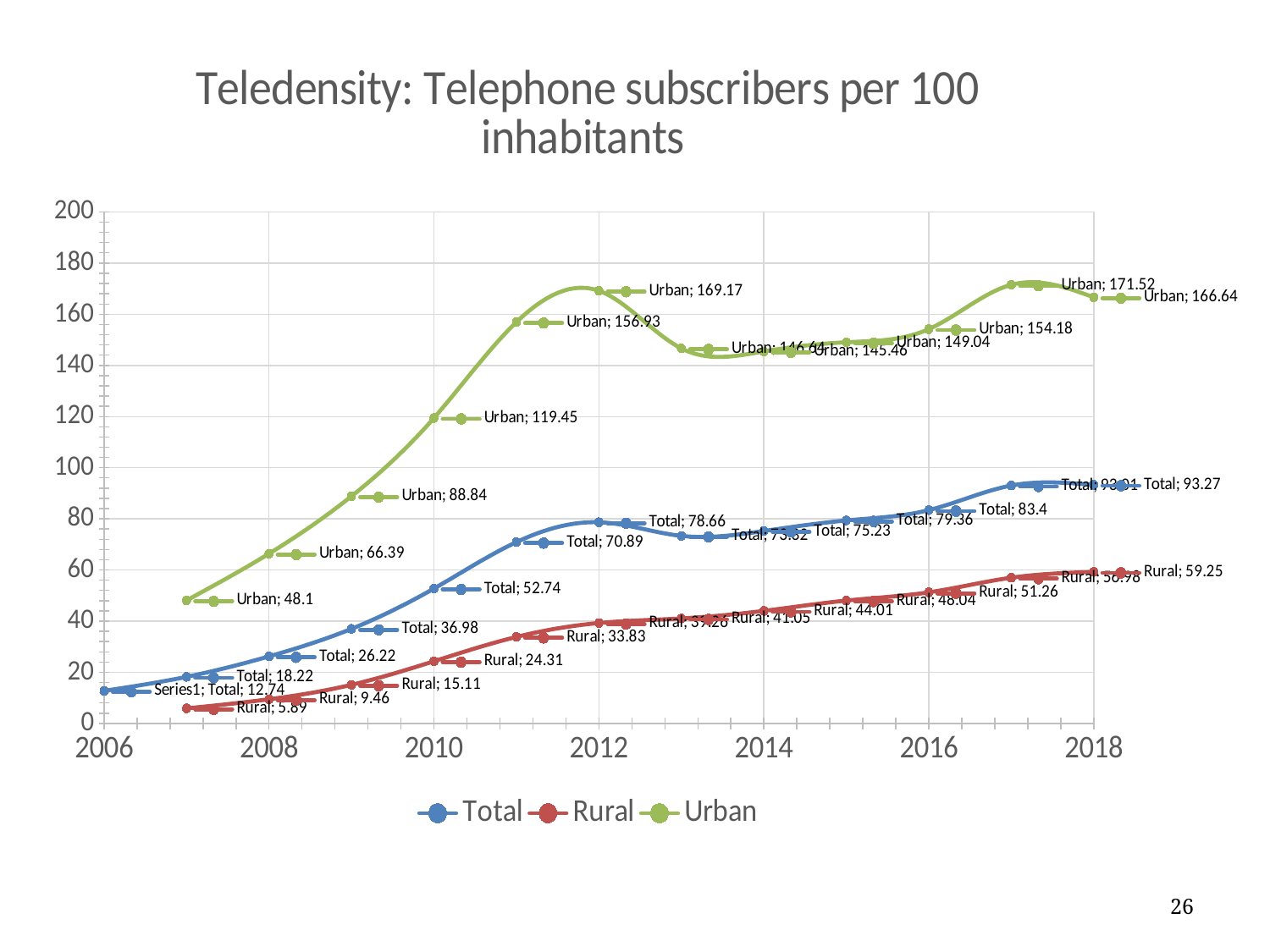
What is the Urban value in 2012? 169.17 How many series does the legend list? 3 What is the Total value in 2010? 52.74 What is the difference between the Urban values in 2017 and 2018? 4.88 What is the Rural value in 2018? 59.25 In which year is the Urban series at its highest? 2017 In which year is the Rural series at its lowest? 2007 Which is larger in 2016, the Total value or the Rural value? Total What is the title of the chart? Teledensity: Telephone subscribers per 100 inhabitants Is the Urban value for 2013 greater or less than 140? greater What kind of chart is shown on the slide? line chart Does the Rural series rise or fall from 2007 to 2018? rise